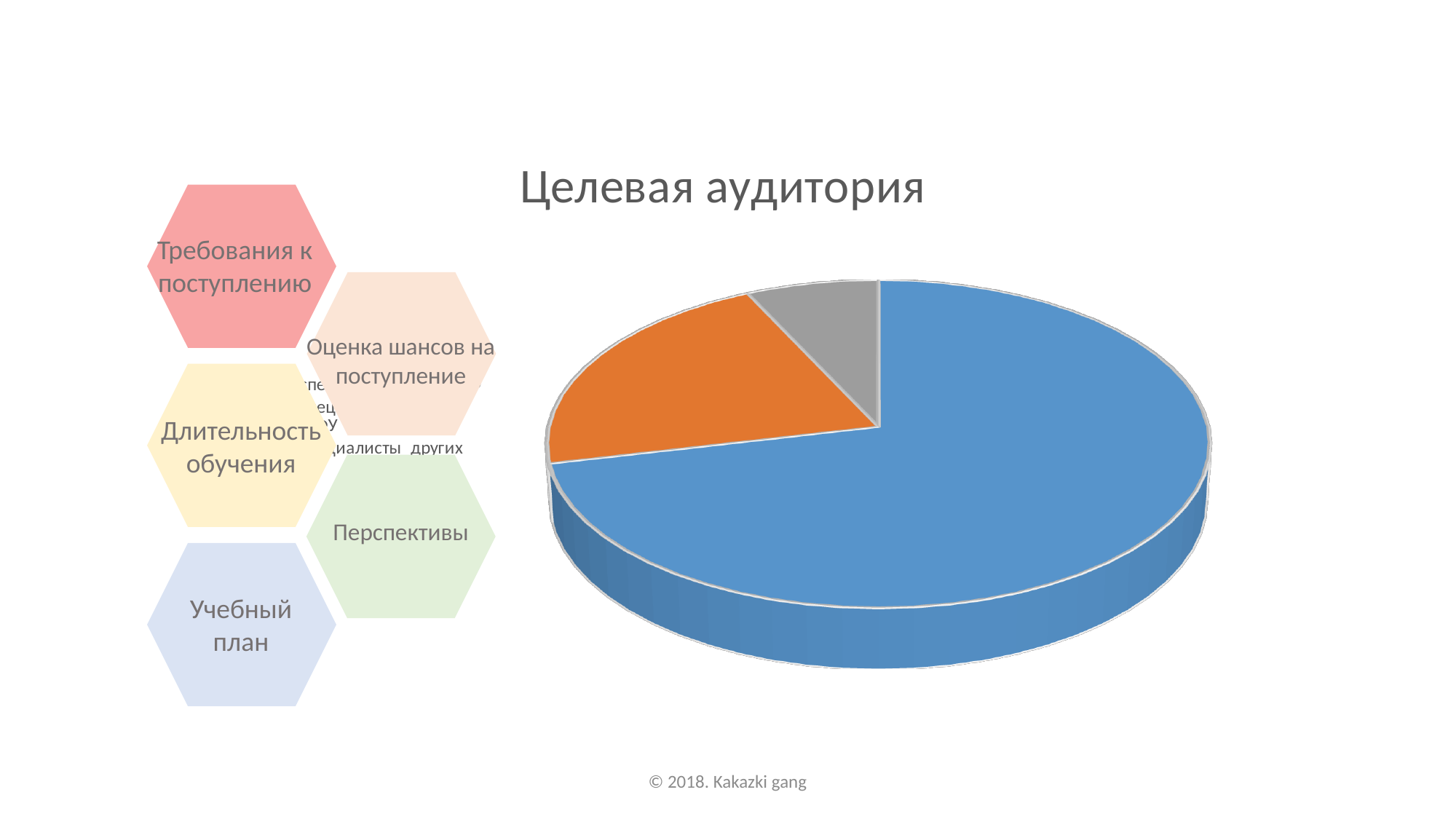
What kind of chart is shown on the slide? Pie chart What is the title of the chart? Целевая аудитория Which colour slice is the smallest in the pie chart? Gray Is the blue slice larger than the orange and gray slices combined? Yes Which colour slice is the largest in the pie chart? Blue How many slices does the pie chart have? 3 Which slice is larger, the orange one or the gray one? Orange Is the pie chart drawn in 3D or flat 2D? 3D